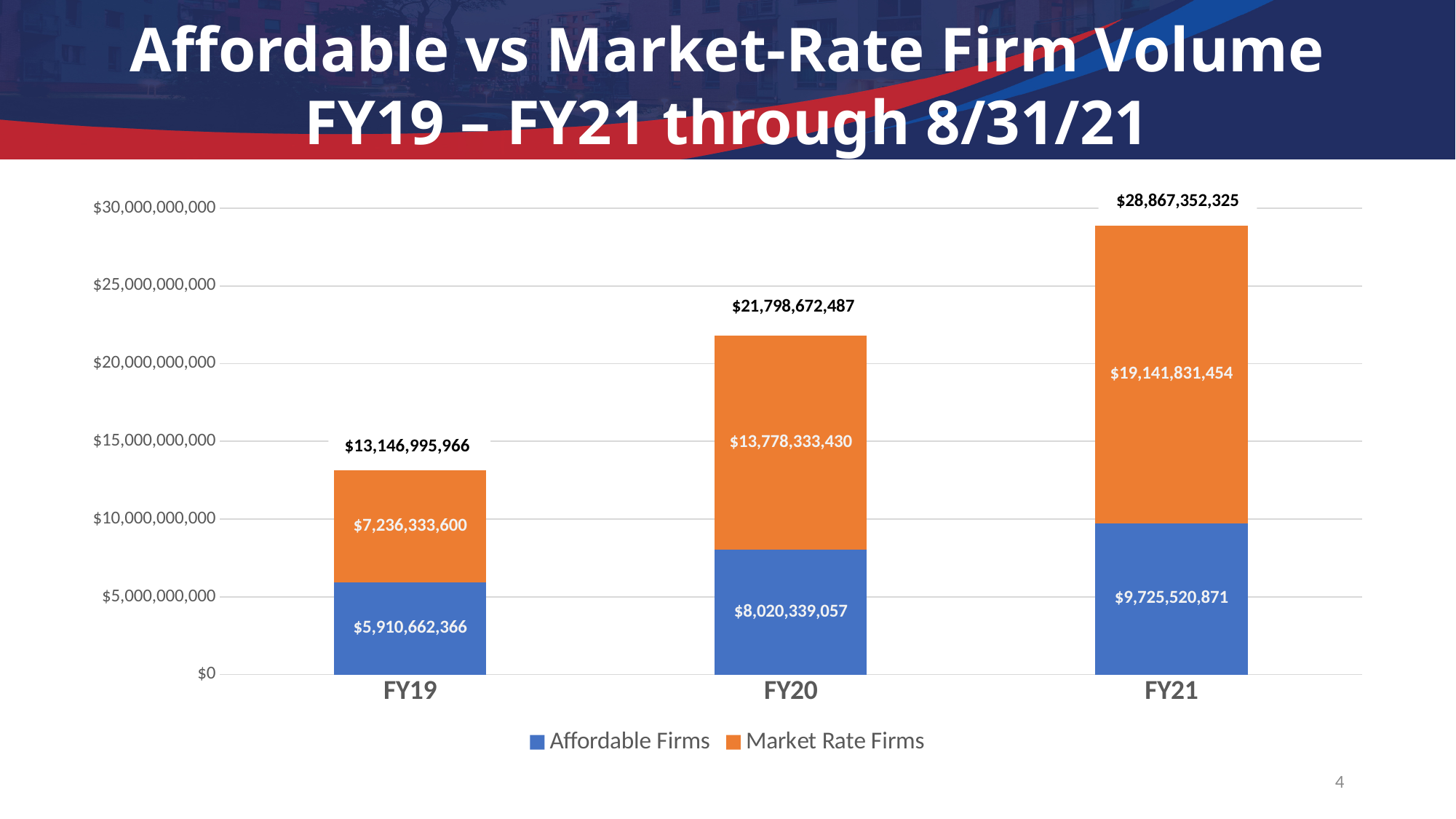
What is the difference between the Market Rate Firms value and the Affordable Firms value in FY21? $9,416,310,583 What is the value for Market Rate Firms in FY20? $13,778,333,430 Is the total for FY19 greater or less than $15,000,000,000? less Which fiscal year has the highest total firm volume? FY21 Which fiscal year has the lowest value for Affordable Firms? FY19 What is the total of the stacked bar for FY20? $21,798,672,487 Does the total firm volume rise or fall from FY19 to FY21? rise Which is larger in FY20: Affordable Firms or Market Rate Firms? Market Rate Firms How many series does the legend list? 2 What is the value for Market Rate Firms in FY21? $19,141,831,454 What is the value for Affordable Firms in FY19? $5,910,662,366 How many fiscal years are shown on the x axis? 3